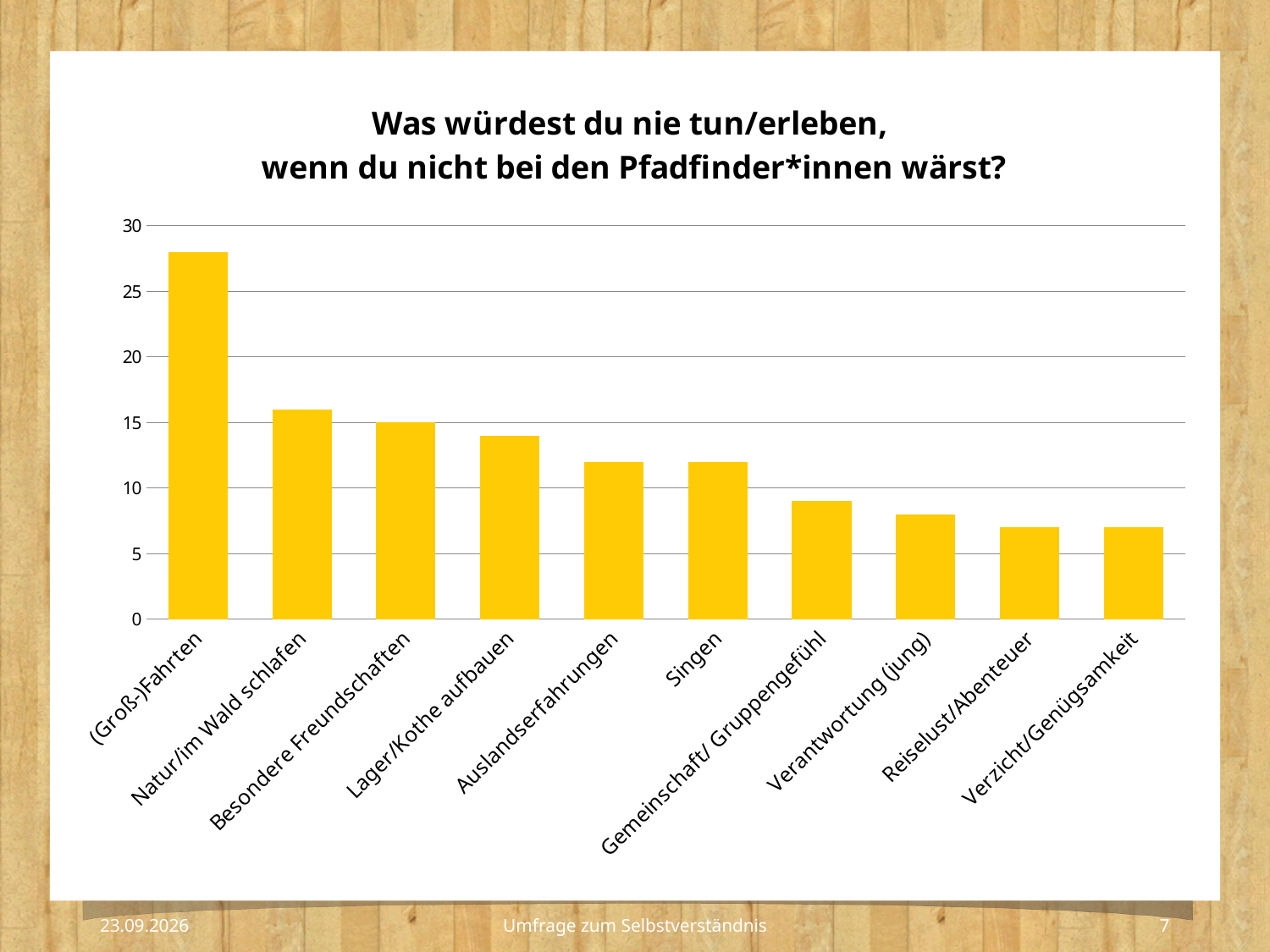
Is the value for (Groß-)Fahrten greater or less than 25? greater Is the value for Singen greater or less than 15? less Do the values generally rise or fall from left to right along the x axis? fall What kind of chart is shown on the slide? bar chart What is the value for Besondere Freundschaften? 15 How many categories are shown on the x axis of the chart? 10 What is the title of the chart? Was würdest du nie tun/erleben, wenn du nicht bei den Pfadfinder*innen wärst? Is the value for Verzicht/Genügsamkeit greater or less than 5? greater Which is larger, the value for (Groß-)Fahrten or the value for Singen? (Groß-)Fahrten Which category has the highest value in the chart? (Groß-)Fahrten